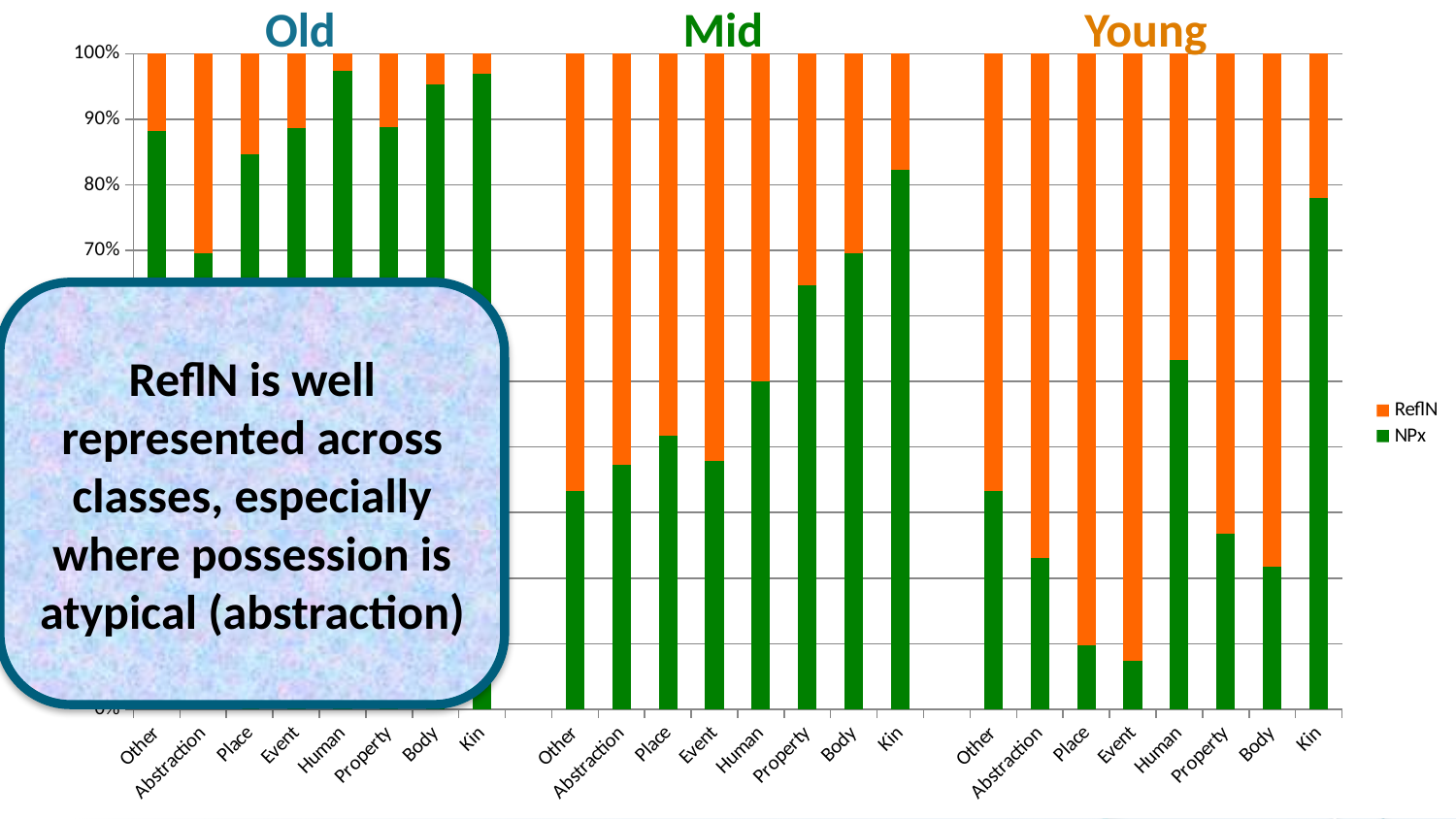
Which category in the Mid group has the highest NPx share? Kin How many categories are plotted within the Mid group? 8 Is the NPx value for Kin in the Mid group greater or less than 90%? less How many series does the legend list? 2 Which category in the Old group has the lowest NPx share? Abstraction Is the NPx value for Human in the Old group greater or less than 90%? greater In the Young group, which has the larger NPx share: Human or Abstraction? Human What kind of chart is shown on the slide? Stacked bar chart What are the three group headings above the chart? Old, Mid, Young Is the NPx value for Other in the Mid group greater or less than 70%? less Which series is shown in green in the legend? NPx